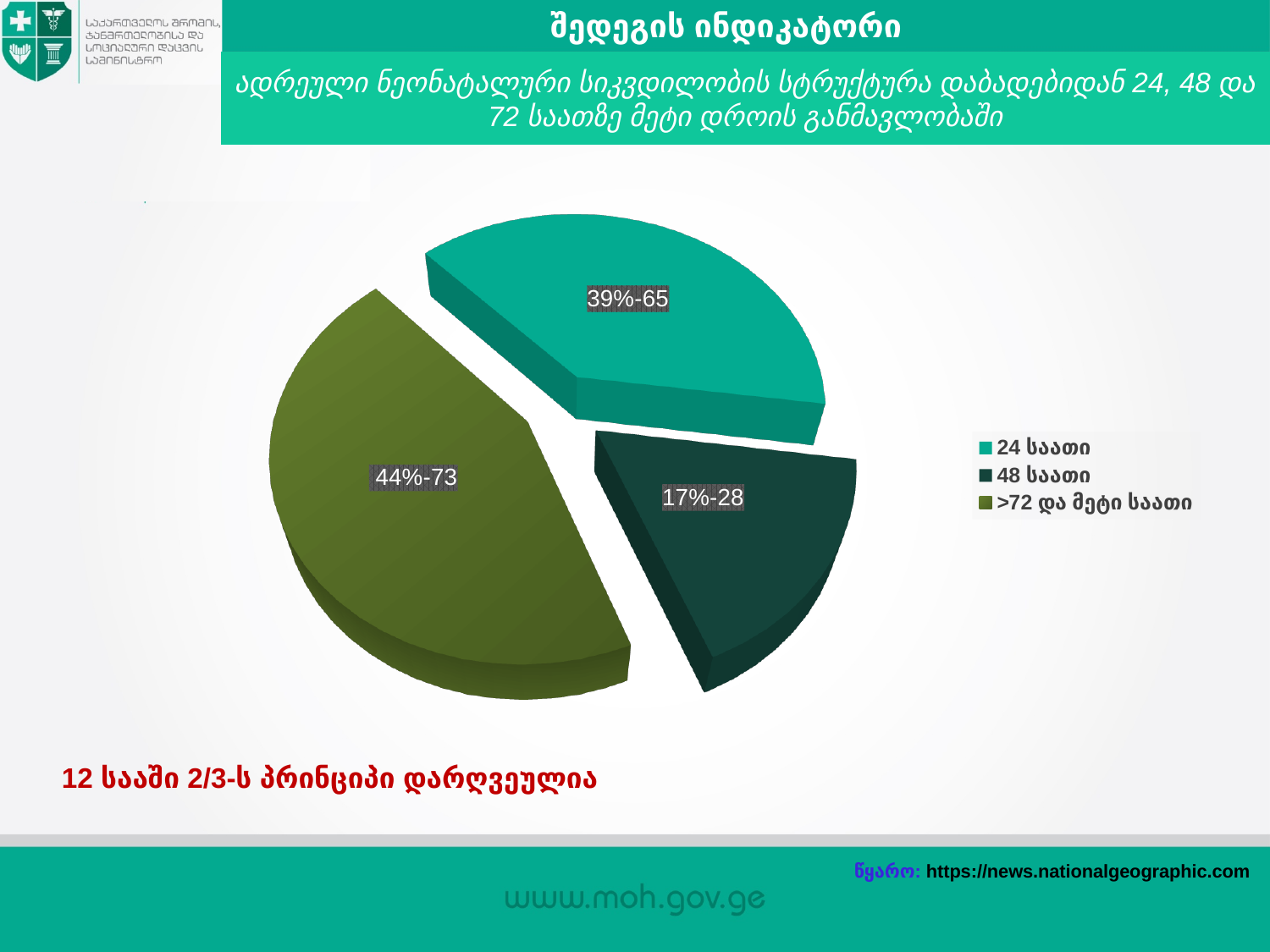
How many entries does the legend of the pie chart list? 3 Which category has the largest share of the pie? >72 და მეტი საათი How many slices does the pie chart have? 3 What percentage share of the pie does the "48 საათი" slice have? 17% What is the difference in percentage points between the ">72 და მეტი საათი" slice and the "24 საათი" slice? 5 What colour is the slice for "24 საათი" in the pie chart? teal Which is larger, the share for "24 საათი" or the share for "48 საათი"? 24 საათი What is the data label shown on the slice for ">72 და მეტი საათი"? 44%-73 What kind of chart is shown on the slide? pie chart What is the data label shown on the slice for "48 საათი"? 17%-28 Which category has the smallest share of the pie? 48 საათი What is the data label shown on the slice for "24 საათი"? 39%-65